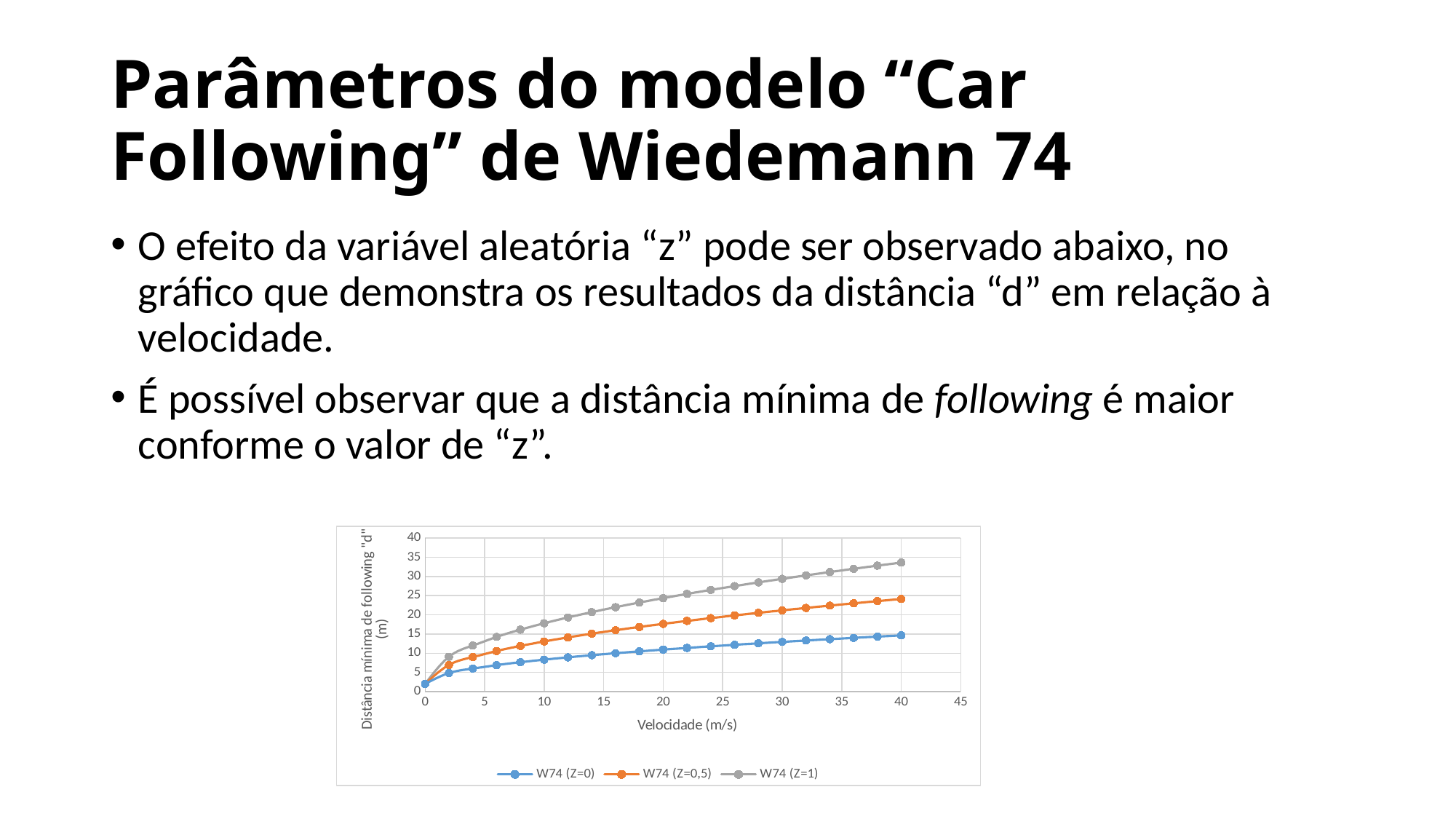
Do the values of the W74 (Z=1) series rise or fall as speed increases along the x axis? rise Which series has the lowest following distance at a speed of 40 m/s? W74 (Z=0) Is the value for W74 (Z=0) at 10 m/s greater or less than 10? less What kind of chart is shown on the slide? line chart What colour is the line for the W74 (Z=1) series? grey Is the value for W74 (Z=0) at 40 m/s greater or less than 20? less What is the title of the x axis of the chart? Velocidade (m/s) Is the value for W74 (Z=1) at 40 m/s greater or less than 30? greater How many series does the chart legend list? 3 At 20 m/s, which is larger: the value for W74 (Z=0,5) or the value for W74 (Z=0)? W74 (Z=0,5) Which series has the highest following distance at a speed of 40 m/s? W74 (Z=1)